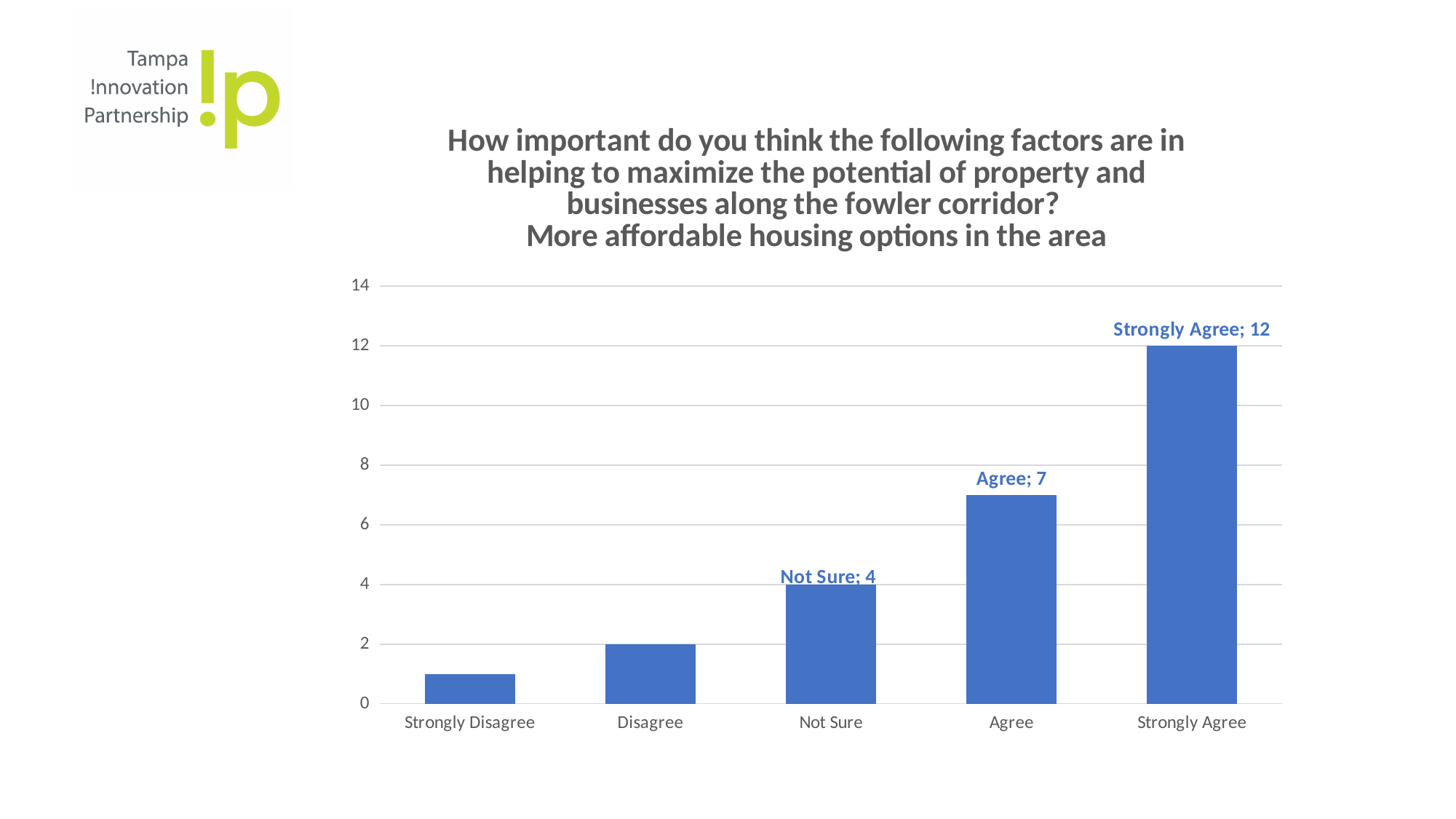
Do the values rise or fall from Strongly Disagree to Strongly Agree along the x axis? rise What is the value for Not Sure? 4 How many categories are shown on the x axis? 5 What is the value for Disagree? 2 What is the difference between the values for Strongly Agree and Agree? 5 What is the value for Agree? 7 What kind of chart is shown on the slide? bar chart Is the value for Strongly Disagree greater or less than 2? less What is the value for Strongly Agree? 12 Which category has the lowest value? Strongly Disagree Which is larger, the value for Not Sure or the value for Agree? Agree Which category has the highest value? Strongly Agree